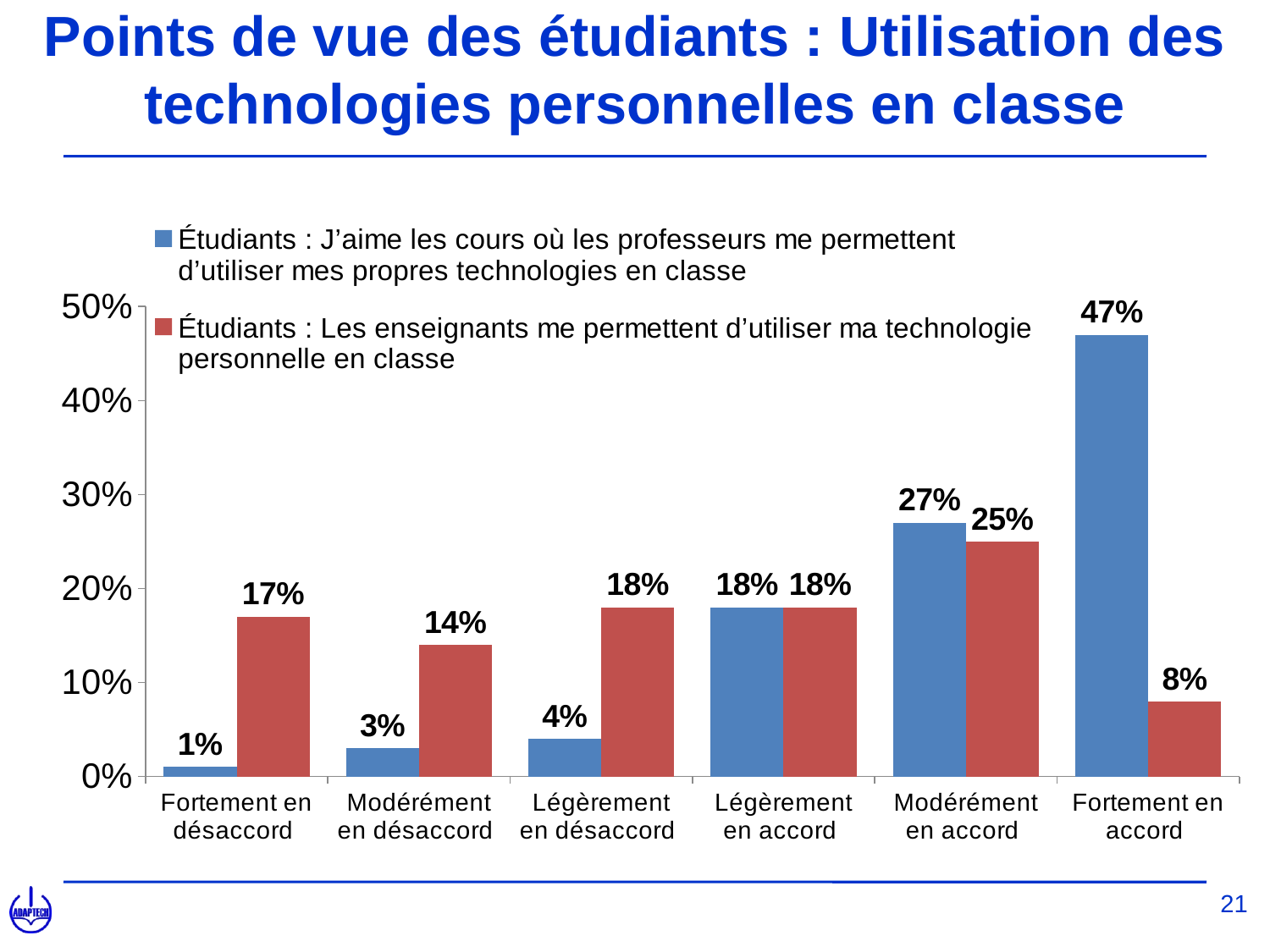
What is the difference between the two series' values for "Fortement en accord"? 39% Which category has the lowest value in the series "Étudiants : J'aime les cours où les professeurs me permettent d'utiliser mes propres technologies en classe"? Fortement en désaccord What is the value for "Fortement en accord" in the series "Étudiants : J'aime les cours où les professeurs me permettent d'utiliser mes propres technologies en classe"? 47% For "Légèrement en désaccord", which series has the larger value? Étudiants : Les enseignants me permettent d'utiliser ma technologie personnelle en classe What is the value for "Modérément en accord" in the series "Étudiants : Les enseignants me permettent d'utiliser ma technologie personnelle en classe"? 25% How many series does the legend list? 2 Which category has the highest value in the series "Étudiants : J'aime les cours où les professeurs me permettent d'utiliser mes propres technologies en classe"? Fortement en accord What kind of chart is shown on the slide? Bar chart How many categories are shown on the x axis? 6 Which category has the lowest value in the series "Étudiants : Les enseignants me permettent d'utiliser ma technologie personnelle en classe"? Fortement en accord What is the value for "Fortement en désaccord" in the series "Étudiants : Les enseignants me permettent d'utiliser ma technologie personnelle en classe"? 17% What is the difference between the two series' values for "Modérément en désaccord"? 11%